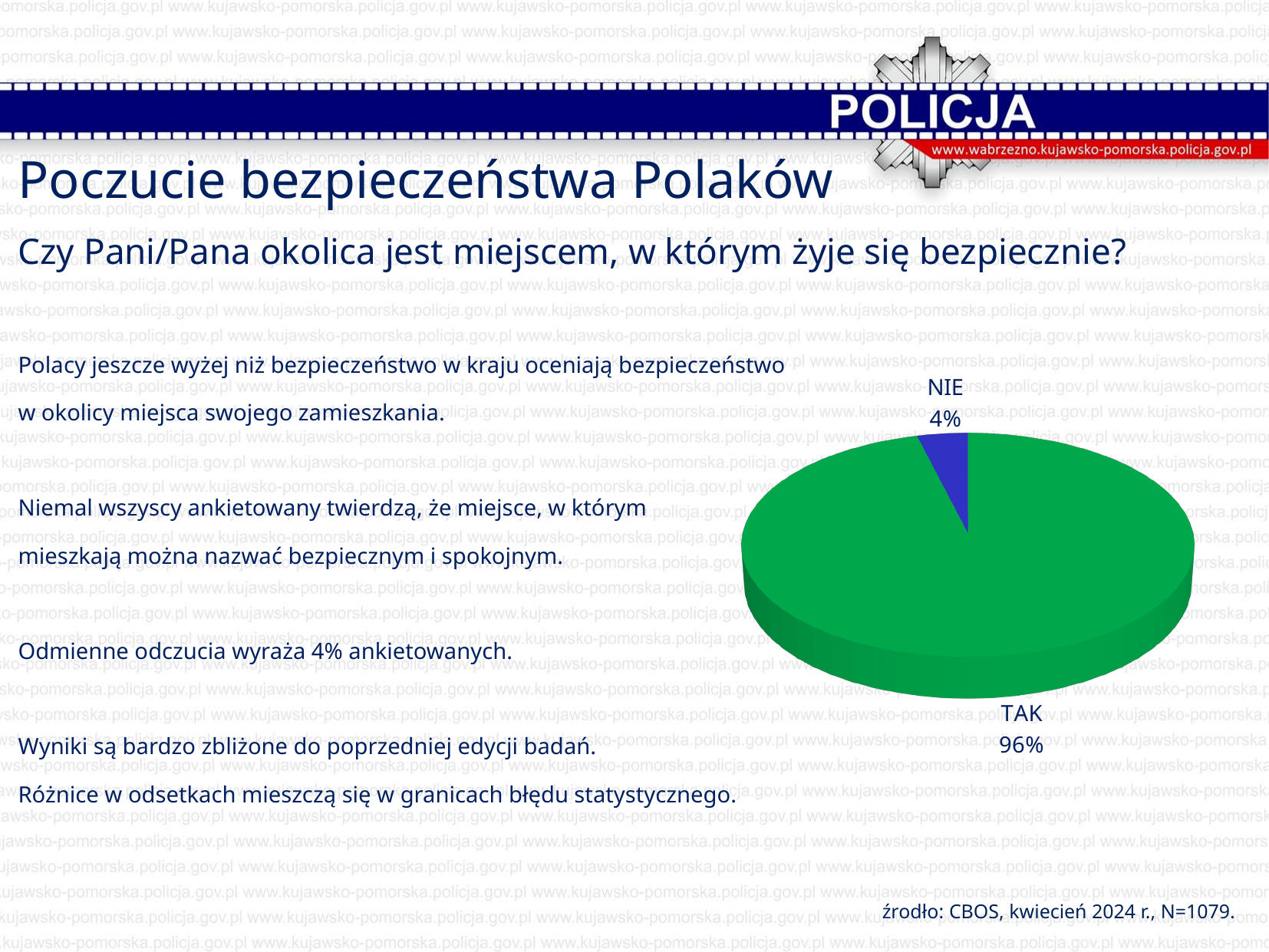
What kind of chart is shown on the slide? pie chart What colour is the NIE slice? blue Which category has the largest share of the pie? TAK What colour is the TAK slice? green Which category has the smallest share of the pie? NIE Which is larger, the share for TAK or the share for NIE? TAK How many slices does the pie chart have? 2 What percentage of respondents answered TAK? 96% What percentage of respondents answered NIE? 4% What is the difference in percentage points between TAK and NIE? 92 What share of the pie does the NIE slice represent? 4%